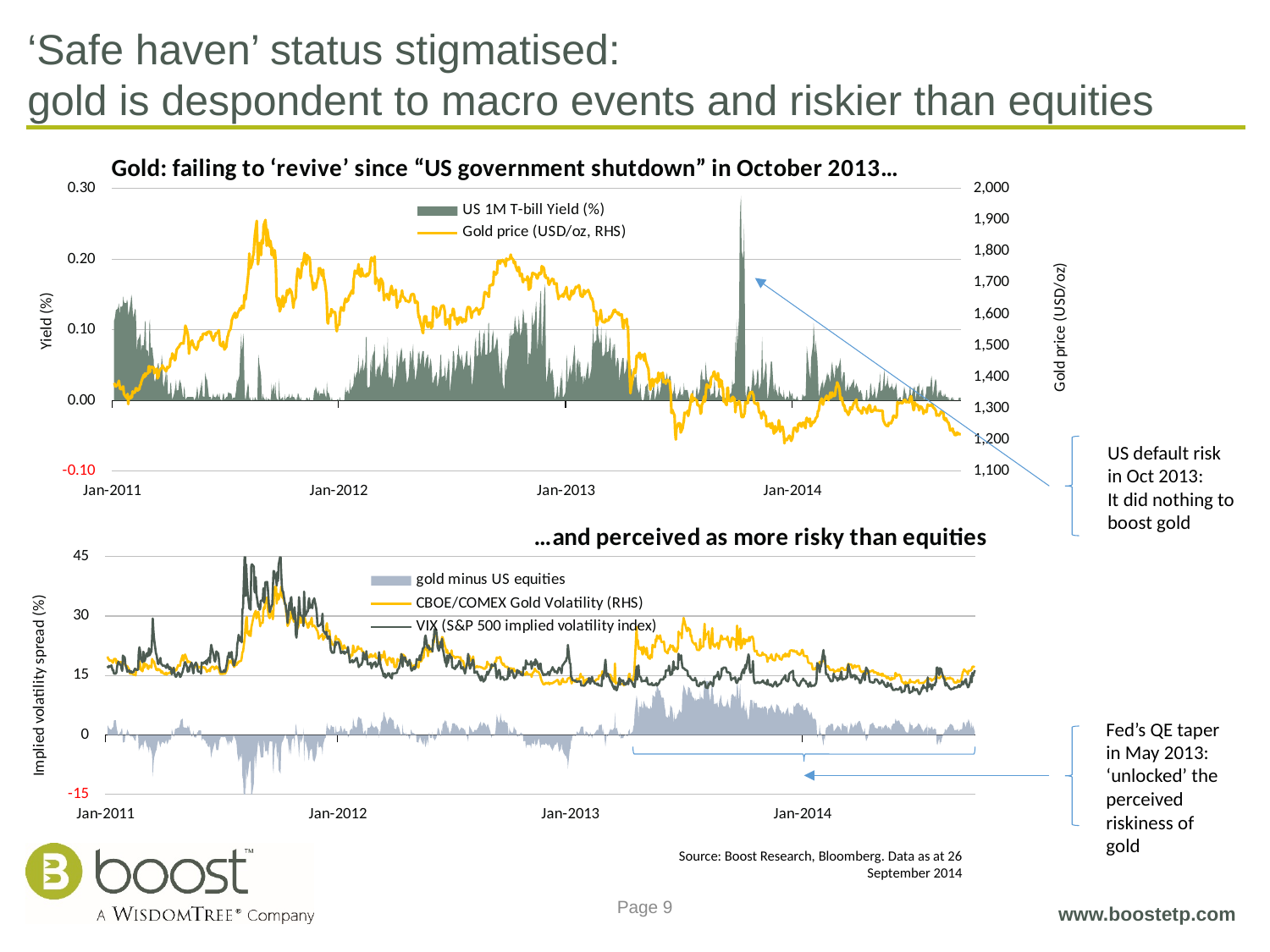
How many series does the legend of the top chart list? 2 In the top chart, is the gold price at the end of the series (September 2014) greater or less than 1,300 USD/oz? less In the top chart, which series is plotted against the right-hand axis? Gold price (USD/oz, RHS) In the bottom chart, is the peak of the VIX in late 2011 greater or less than 30? greater What type of chart is the top chart titled "Gold: failing to 'revive' since "US government shutdown" in October 2013…"? Combined area and line chart In the bottom chart, is the 'gold minus US equities' spread in mid-2013 greater or less than 0? greater How many series does the legend of the bottom chart ("…and perceived as more risky than equities") list? 3 In the bottom chart, which series is shown as a yellow line? CBOE/COMEX Gold Volatility (RHS) How many year labels are shown on the x axis of the bottom chart? 4 In the top chart, does the gold price rise or fall between Jan-2013 and Jan-2014? fall